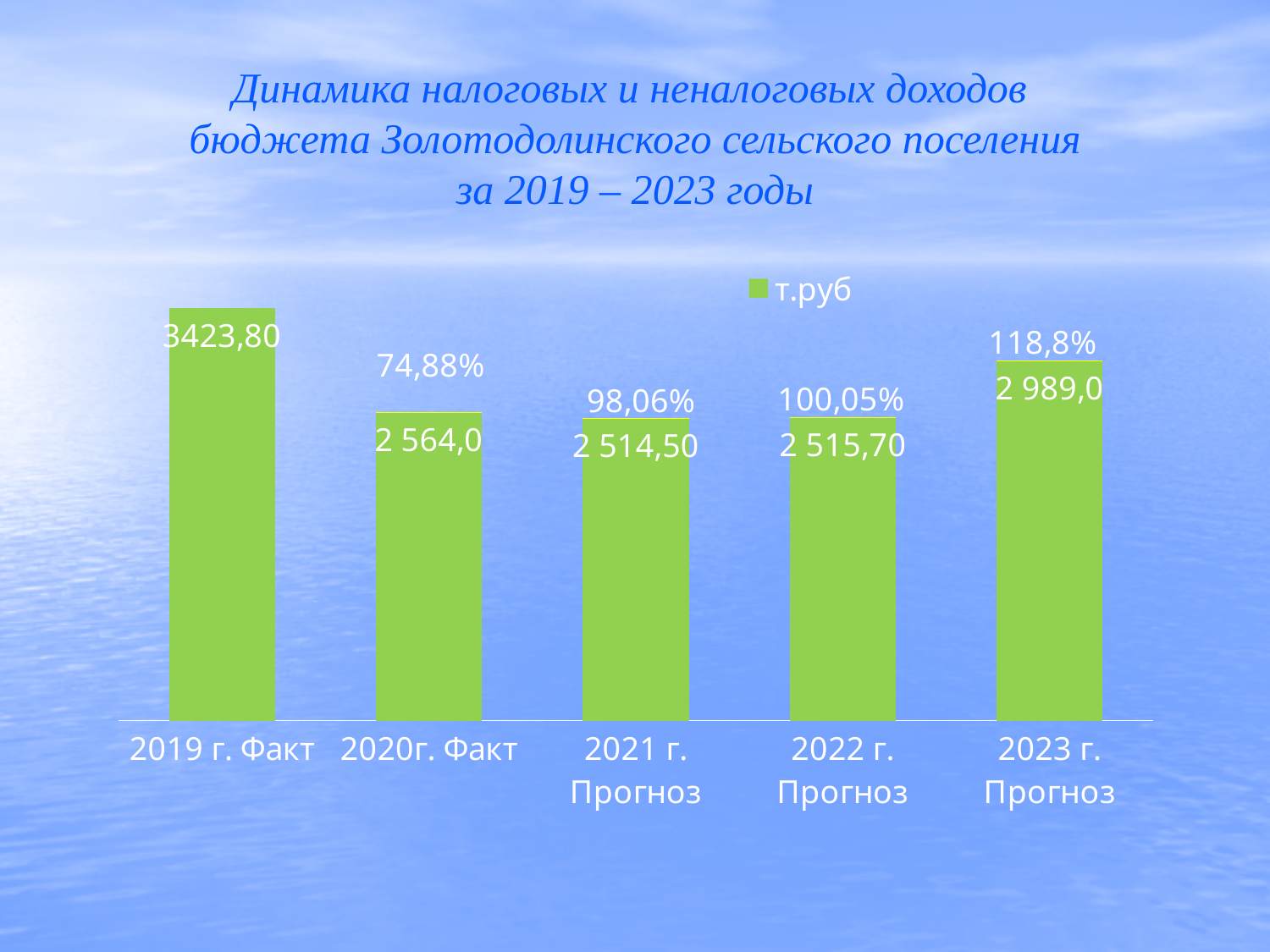
What is the value for 2019 г. Факт? 3423,80 Which category has the highest value? 2019 г. Факт What is the legend entry for the series? т.руб What is the value for 2020г. Факт? 2 564,0 How many categories are shown on the x axis? 5 What is the difference between the values for 2019 г. Факт and 2020г. Факт? 859,80 What percentage is shown above the bar for 2020г. Факт? 74,88% What kind of chart is shown on the slide? bar chart What percentage is shown above the bar for 2022 г. Прогноз? 100,05% Which is larger, the value for 2020г. Факт or for 2023 г. Прогноз? 2023 г. Прогноз Which category has the lowest value? 2021 г. Прогноз What is the value for 2023 г. Прогноз? 2 989,0